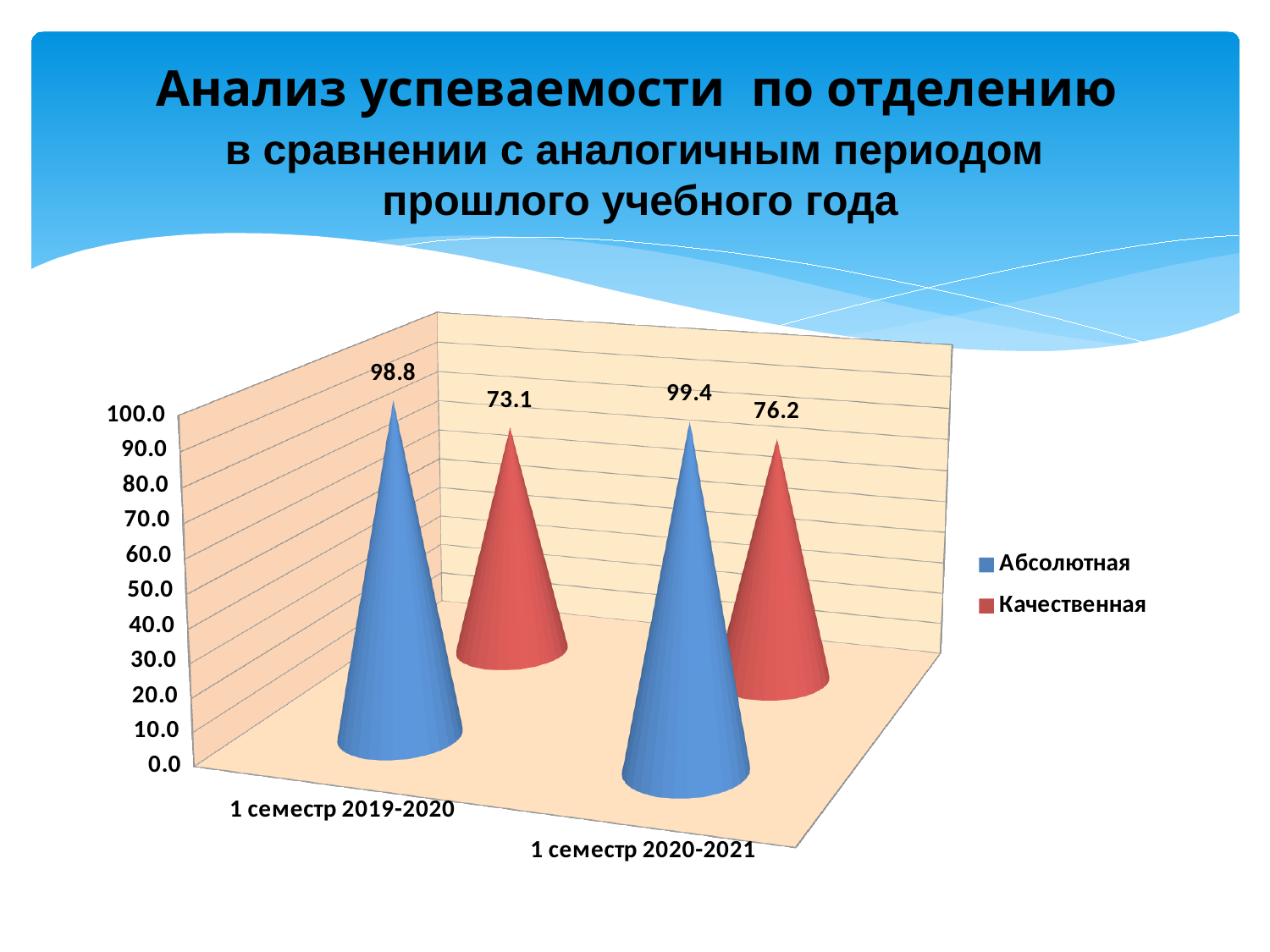
What is the difference between the Абсолютная and Качественная values for 1 семестр 2019-2020? 25.7 What is the value of Качественная for 1 семестр 2019-2020? 73.1 Which category has the lowest Качественная value? 1 семестр 2019-2020 What is the value of Качественная for 1 семестр 2020-2021? 76.2 Which category has the highest Качественная value? 1 семестр 2020-2021 How many categories are shown on the x axis? 2 How many series does the legend list? 2 Which is larger for 1 семестр 2020-2021: Абсолютная or Качественная? Абсолютная Does the Качественная value rise or fall from 1 семестр 2019-2020 to 1 семестр 2020-2021? rise What is the value of Абсолютная for 1 семестр 2019-2020? 98.8 What is the value of Абсолютная for 1 семестр 2020-2021? 99.4 What is the difference between the Качественная values for 1 семестр 2020-2021 and 1 семестр 2019-2020? 3.1